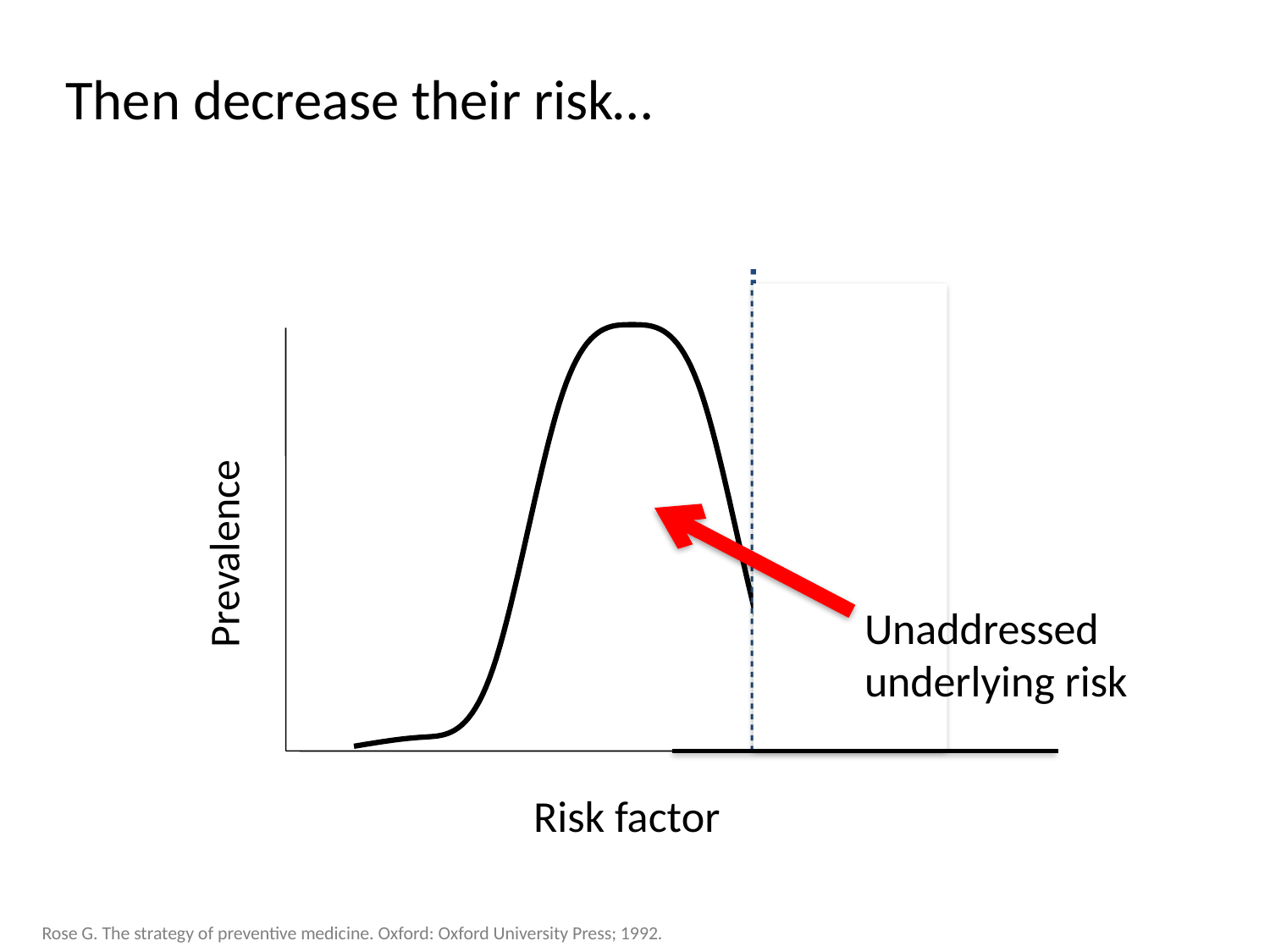
Does the curve rise or fall as the risk factor increases from the left edge up to the peak? rise How many curves are plotted on the chart? 1 What is the label on the vertical axis of the chart? Prevalence What kind of chart is shown on the slide? line chart After the peak, does the curve rise or fall as the risk factor increases toward the dotted line? fall What does the red arrow on the chart point to, according to its label? Unaddressed underlying risk